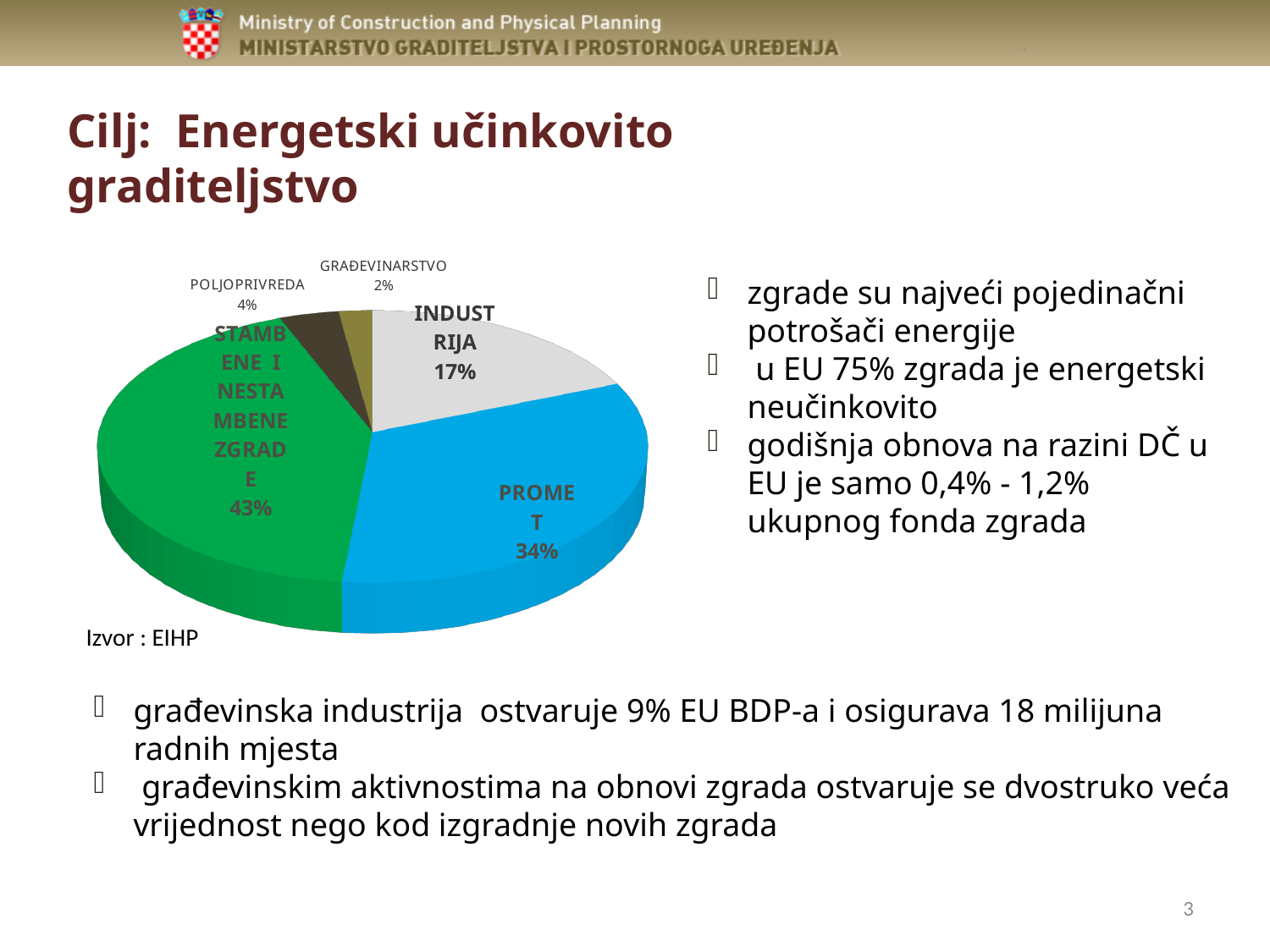
Which is larger, the share for INDUSTRIJA or the share for POLJOPRIVREDA? INDUSTRIJA What share of the pie does POLJOPRIVREDA have? 4% Which category has the largest slice of the pie? STAMBENE I NESTAMBENE ZGRADE What share of the pie does STAMBENE I NESTAMBENE ZGRADE have? 43% What share of the pie does PROMET have? 34% What share of the pie does GRAĐEVINARSTVO have? 2% How many slices does the pie chart have? 5 What kind of chart is shown on the slide? Pie chart Which category has the smallest slice of the pie? GRAĐEVINARSTVO What source is cited below the pie chart? EIHP What share of the pie does INDUSTRIJA have? 17% What is the difference in percentage points between STAMBENE I NESTAMBENE ZGRADE and PROMET? 9